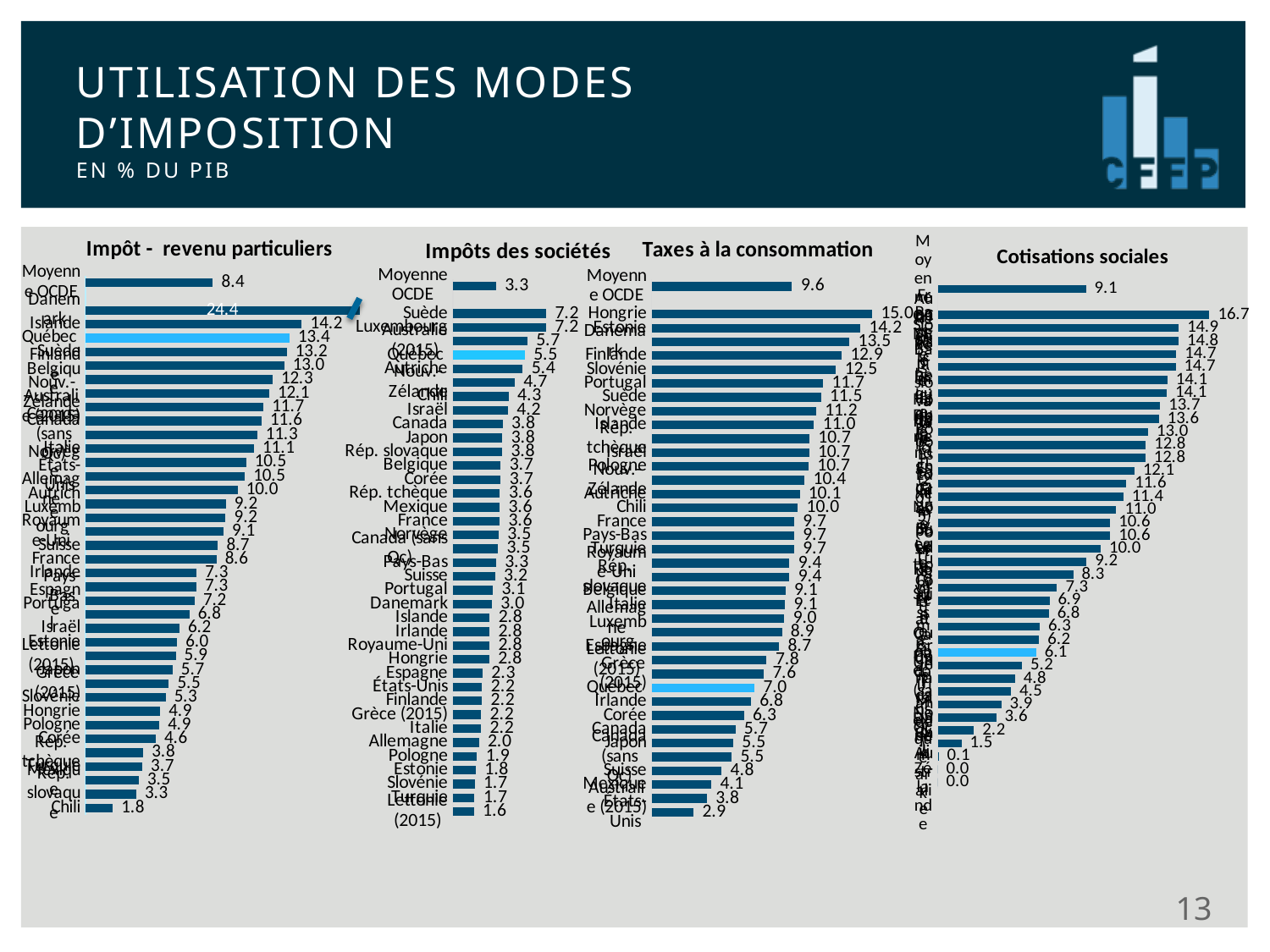
In the 'Impôts des sociétés' chart, what is the value for Québec? 5.5 In the 'Taxes à la consommation' chart, what is the value for Québec? 7.0 In the 'Impôt - revenu particuliers' chart, what is the value for Moyenne OCDE? 8.4 What type of chart is used for 'Cotisations sociales'? Bar chart In the 'Impôts des sociétés' chart, what is the difference between Québec and Moyenne OCDE? 2.2 In the 'Taxes à la consommation' chart, which country has the highest value? Hongrie In the 'Impôts des sociétés' chart, what is the value for Moyenne OCDE? 3.3 In the 'Impôt - revenu particuliers' chart, what is the value for Québec? 13.4 In the 'Impôt - revenu particuliers' chart, which country has the lowest value? Chili In the 'Impôts des sociétés' chart, which is larger, Australie or Autriche? Australie In the 'Impôt - revenu particuliers' chart, which country has the highest value? Danemark In the 'Taxes à la consommation' chart, what is the difference between Moyenne OCDE and États-Unis? 6.7